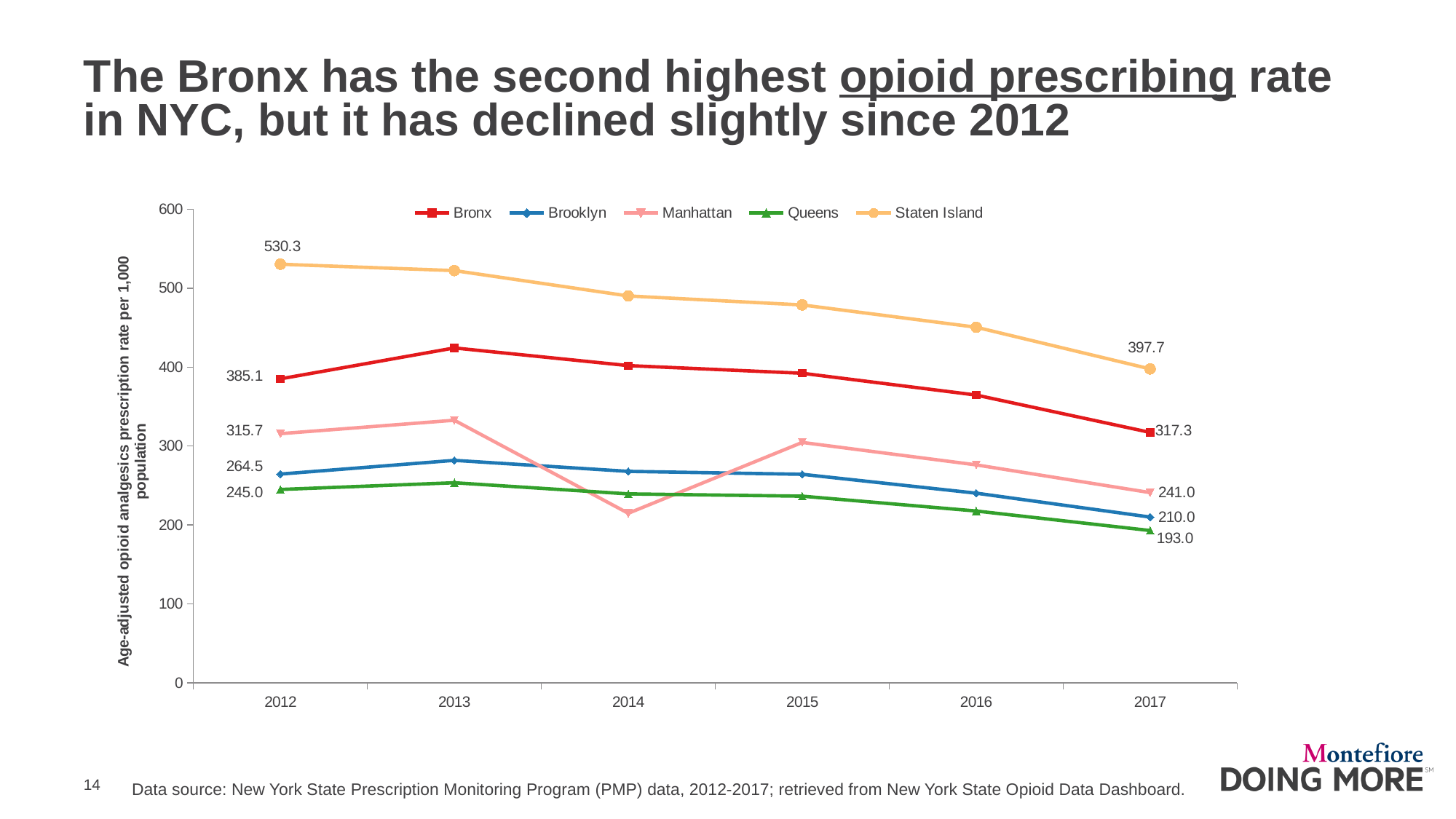
Does the Staten Island opioid prescription rate rise or fall from 2012 to 2017? Fall What was the Queens opioid prescription rate in 2017? 193.0 What was the Staten Island opioid prescription rate in 2017? 397.7 What kind of chart is shown on the slide? Line chart Is the Staten Island value for 2014 greater or less than 400? greater What was the Bronx opioid prescription rate in 2012? 385.1 Which borough had the lowest opioid prescription rate in 2012? Queens In 2017, which was higher: the Brooklyn rate or the Manhattan rate? Manhattan By how much did the Bronx opioid prescription rate decline from 2012 to 2017? 67.8 What was the Manhattan opioid prescription rate in 2012? 315.7 Which borough had the highest opioid prescription rate in 2017? Staten Island How many series does the legend list? 5